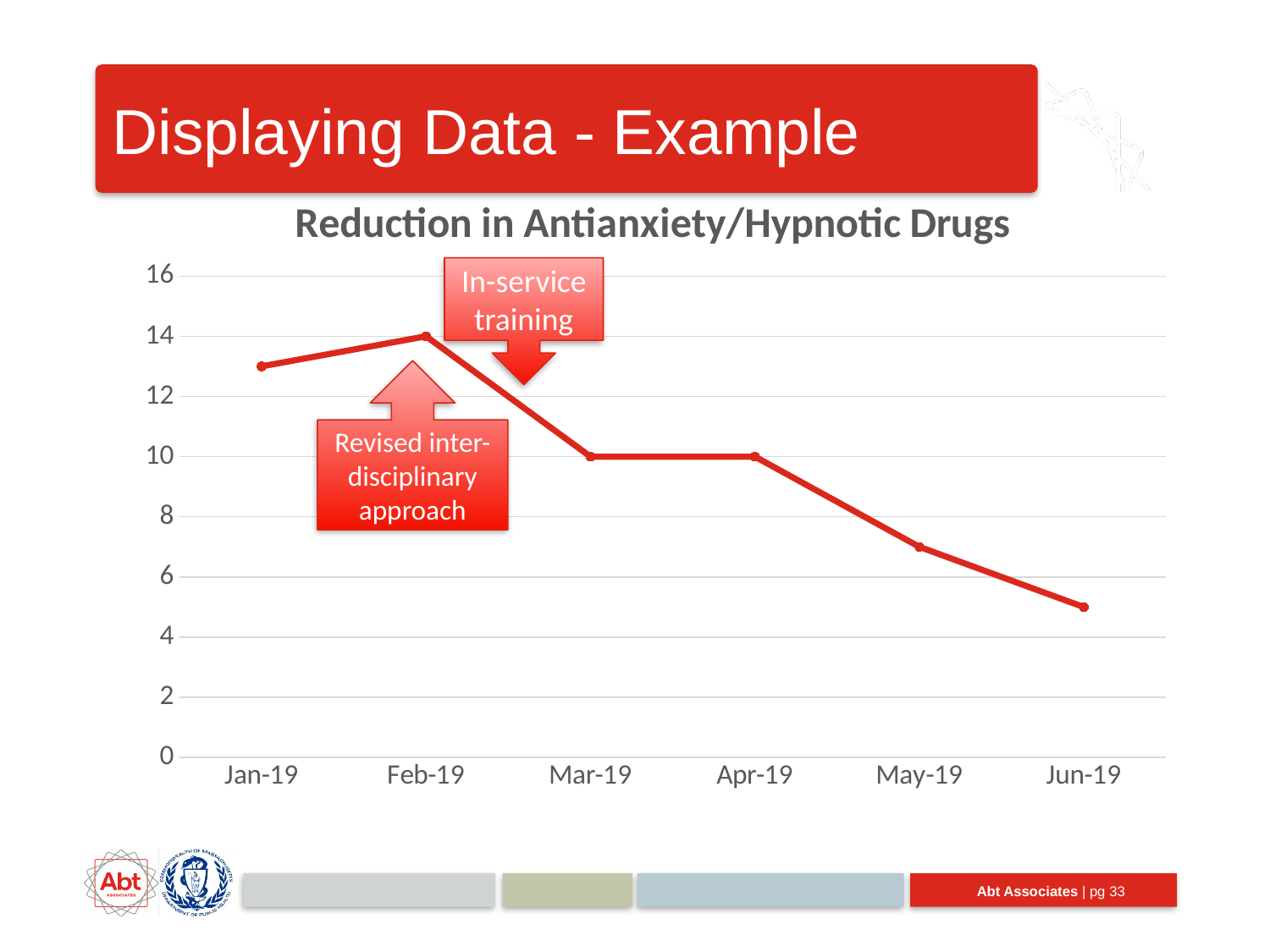
What type of chart is shown on the slide? line chart How many months are plotted on the x axis? 6 What is the difference between the values for Feb-19 and Mar-19? 4 What is the title of the chart? Reduction in Antianxiety/Hypnotic Drugs Which month has the highest value? Feb-19 What is the value for Feb-19? 14 Do the values generally rise or fall from Feb-19 to Jun-19? fall What is the value for Apr-19? 10 Is the value for May-19 greater or less than 8? less Is the value for Jan-19 greater or less than 12? greater What is the value for Mar-19? 10 Which month has the lowest value? Jun-19